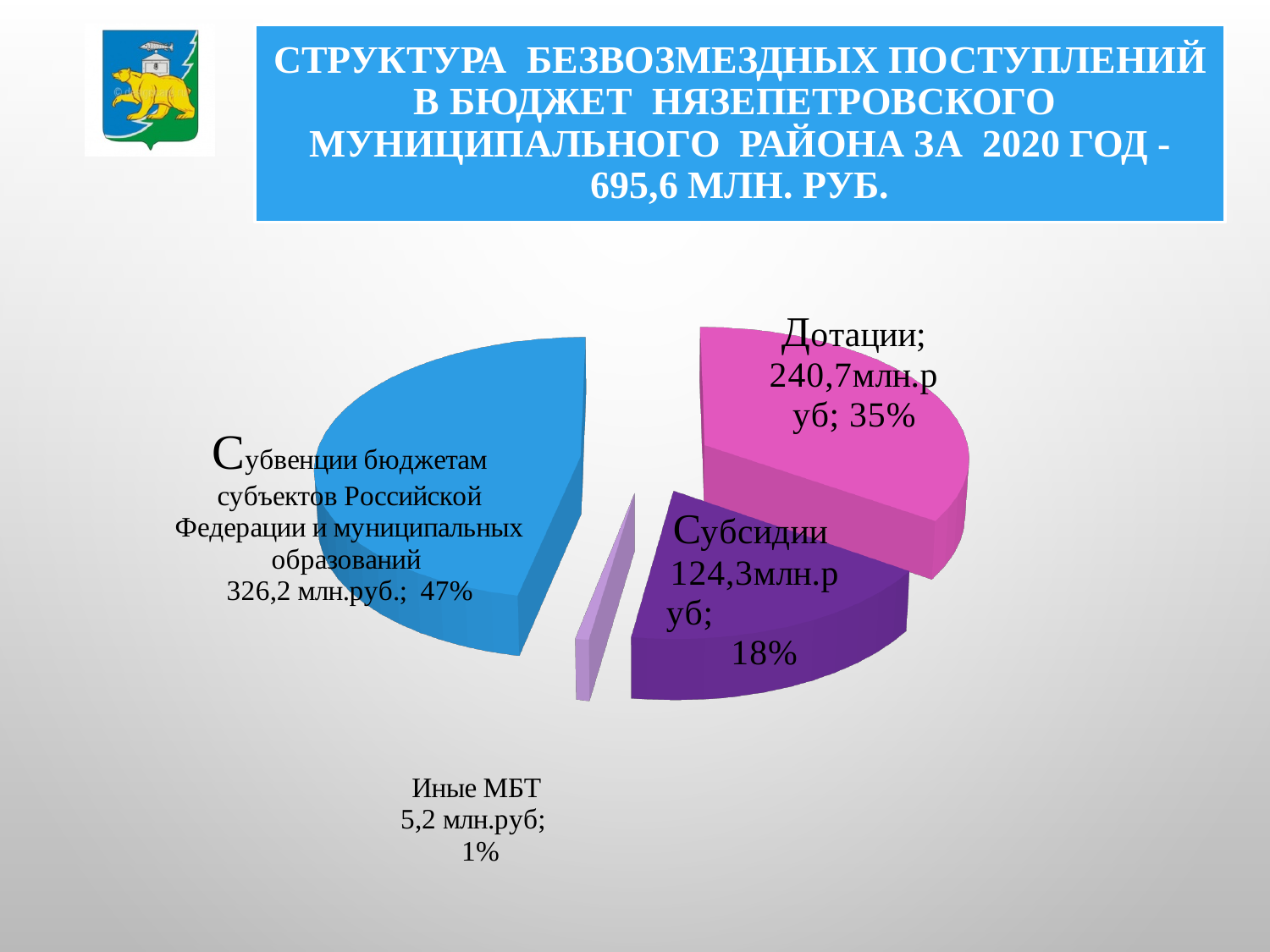
Which is larger, the value for Дотации or the value for Субсидии? Дотации What is the value for Дотации? 240,7 млн.руб What is the value for Субсидии? 124,3 млн.руб What is the value for Субвенции бюджетам субъектов Российской Федерации и муниципальных образований? 326,2 млн.руб. Which category has the smallest share of the pie? Иные МБТ What kind of chart is shown on the slide? Pie chart How many slices does the pie chart have? 4 What is the difference between the values for Дотации and Субсидии? 116,4 млн.руб What share of the pie does Дотации represent? 35% What share of the pie does Субсидии represent? 18% What is the value for Иные МБТ? 5,2 млн.руб Which category has the largest share of the pie? Субвенции бюджетам субъектов Российской Федерации и муниципальных образований